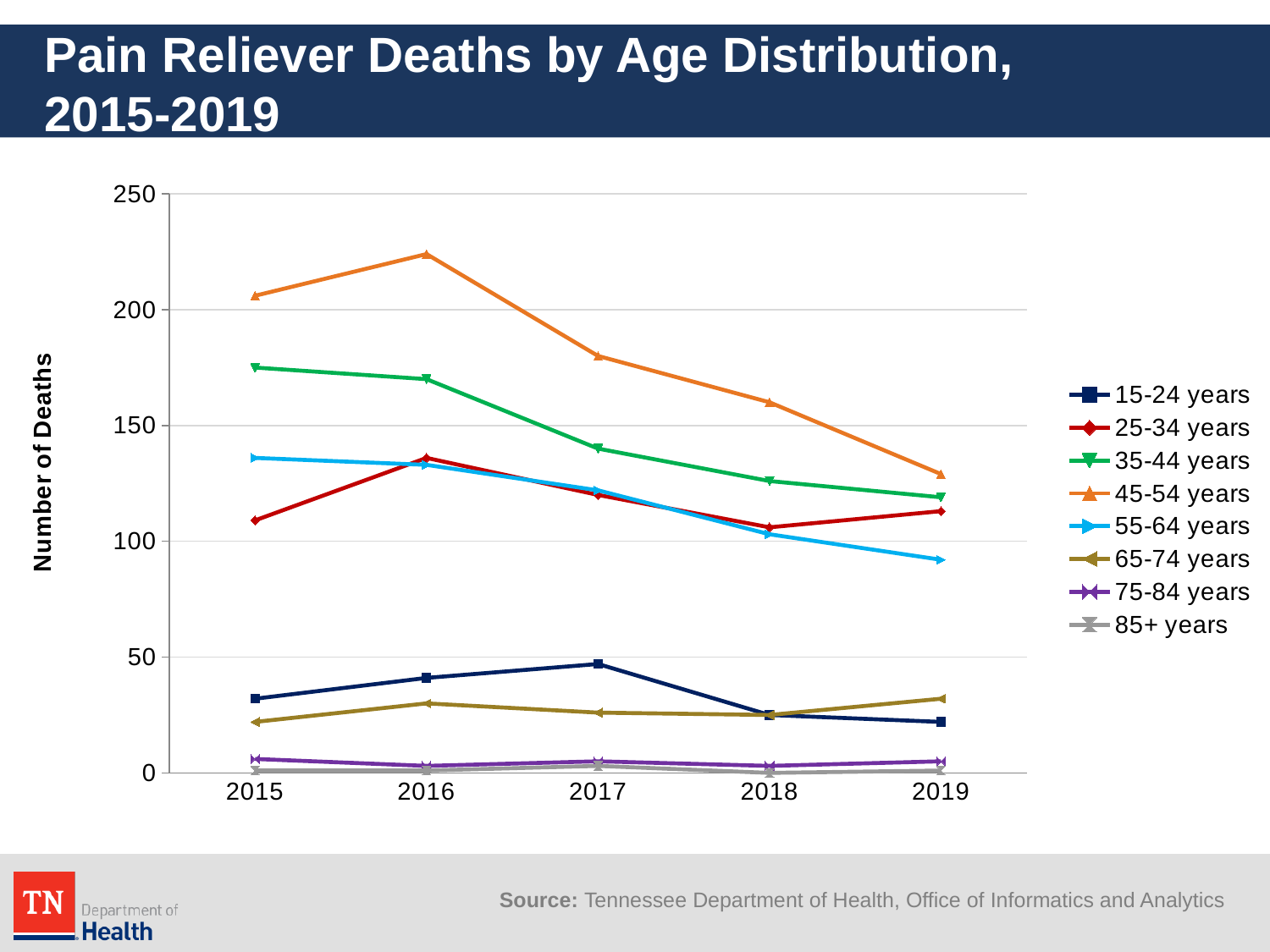
Is the number of deaths for the 15-24 years group in 2018 greater or less than 50? less Is the number of deaths for the 45-54 years group in 2019 greater or less than 150? less How many years are shown along the x axis? 5 In 2019, which group had more deaths: 25-34 years or 55-64 years? 25-34 years Is the number of deaths for the 45-54 years group in 2016 greater or less than 200? greater What is the label on the vertical axis of the chart? Number of Deaths Did the number of deaths for the 45-54 years group rise or fall from 2016 to 2019? Fall What kind of chart is shown on the slide? Line chart How many age groups does the legend list? 8 Which age group had the highest number of pain reliever deaths in 2016? 45-54 years In 2015, which group had more deaths: 25-34 years or 55-64 years? 55-64 years Which age group had the lowest number of pain reliever deaths in 2019? 85+ years